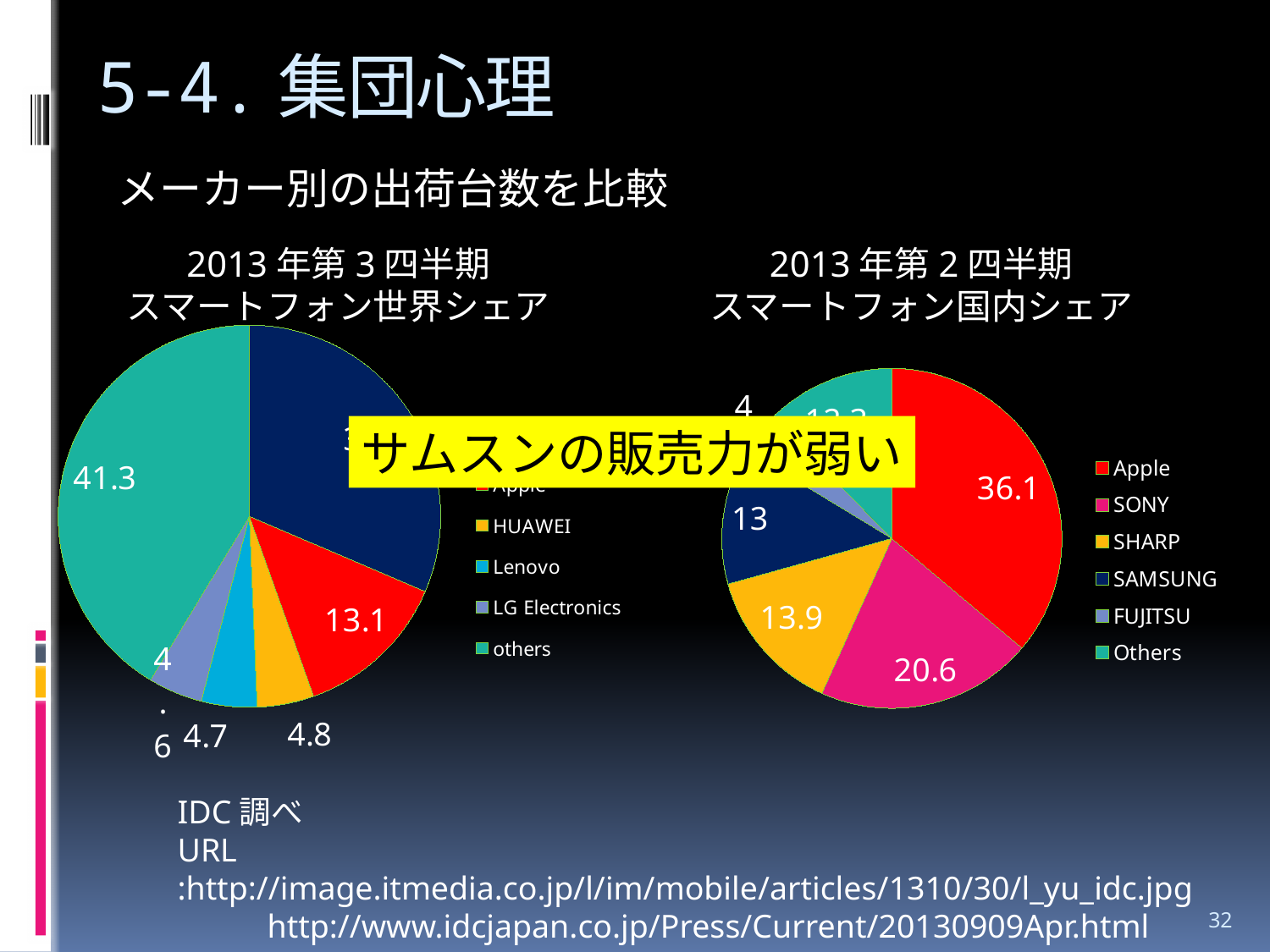
In the left chart (2013年第3四半期 スマートフォン世界シェア), what is the difference between the Apple and HUAWEI values? 8.3 How many entries does the legend of the right chart (2013年第2四半期 スマートフォン国内シェア) list? 6 In the right chart (2013年第2四半期 スマートフォン国内シェア), what is the value for SAMSUNG? 13 What kind of chart is the left chart titled 2013年第3四半期 スマートフォン世界シェア? pie chart In the right chart (2013年第2四半期 スマートフォン国内シェア), what is the difference between the Apple and SONY values? 15.5 In the left chart (2013年第3四半期 スマートフォン世界シェア), what is the value for others? 41.3 In the right chart (2013年第2四半期 スマートフォン国内シェア), what is the value for Apple? 36.1 In the right chart (2013年第2四半期 スマートフォン国内シェア), what is the value for SONY? 20.6 In the left chart (2013年第3四半期 スマートフォン世界シェア), what is the value for HUAWEI? 4.8 In the right chart (2013年第2四半期 スマートフォン国内シェア), what is the value for SHARP? 13.9 In the right chart (2013年第2四半期 スマートフォン国内シェア), which maker has the largest share? Apple In the left chart (2013年第3四半期 スマートフォン世界シェア), what is the value for Apple? 13.1